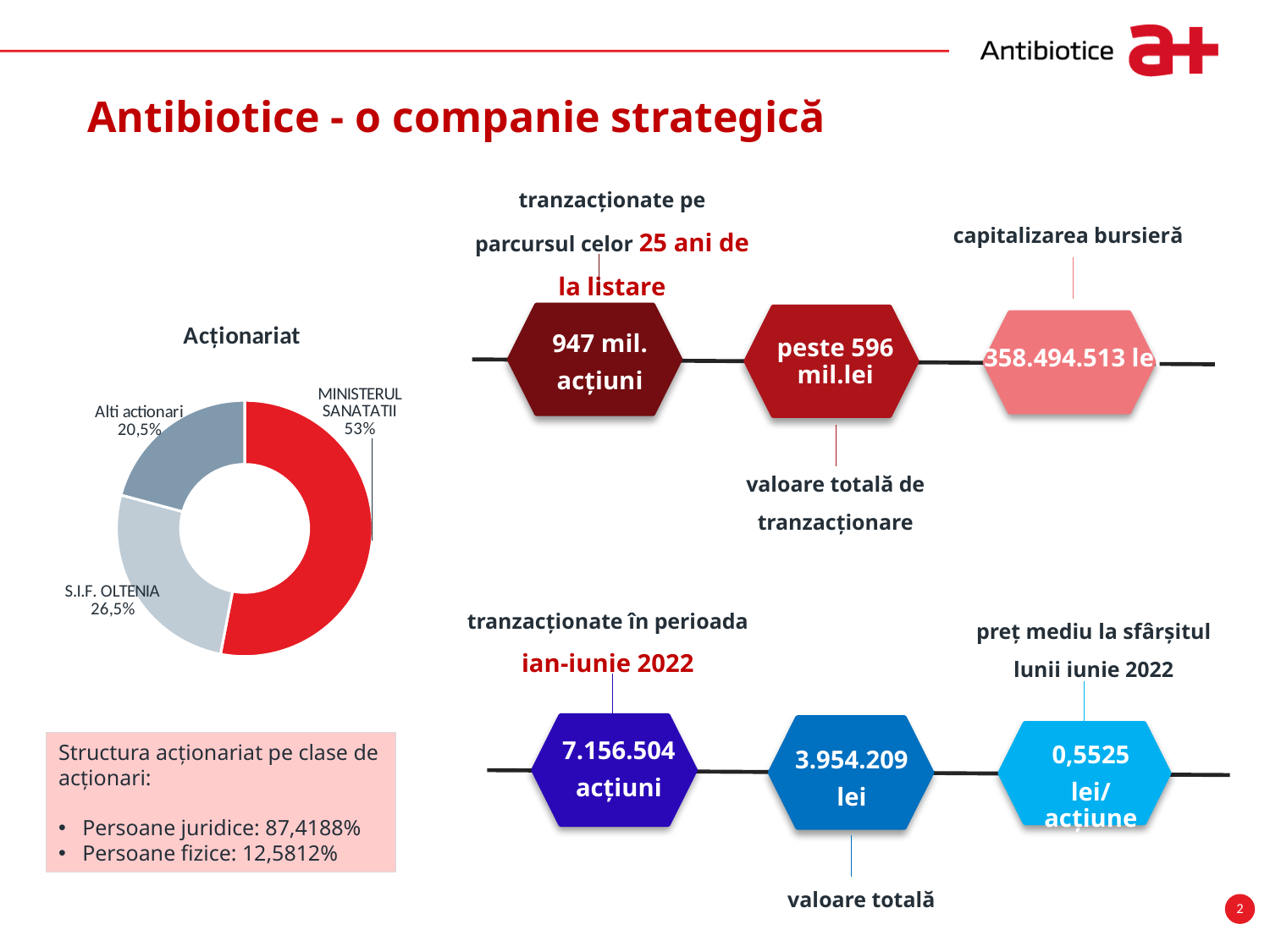
What kind of chart is the "Acționariat" chart? Doughnut chart How many categories are shown in the "Acționariat" chart? 3 In the "Acționariat" chart, what is the difference between the shares of S.I.F. OLTENIA and Alti actionari? 6% What is the title of the doughnut chart on the slide? Acționariat In the "Acționariat" chart, what is the difference between the shares of MINISTERUL SANATATII and S.I.F. OLTENIA? 26,5% In the "Acționariat" chart, which is larger: S.I.F. OLTENIA or Alti actionari? S.I.F. OLTENIA In the "Acționariat" chart, what share does Alti actionari hold? 20,5% Which category has the smallest slice in the "Acționariat" chart? Alti actionari In the "Acționariat" chart, what colour is the MINISTERUL SANATATII slice? Red In the "Acționariat" chart, what share does MINISTERUL SANATATII hold? 53% Which category has the largest slice in the "Acționariat" chart? MINISTERUL SANATATII In the "Acționariat" chart, what share does S.I.F. OLTENIA hold? 26,5%